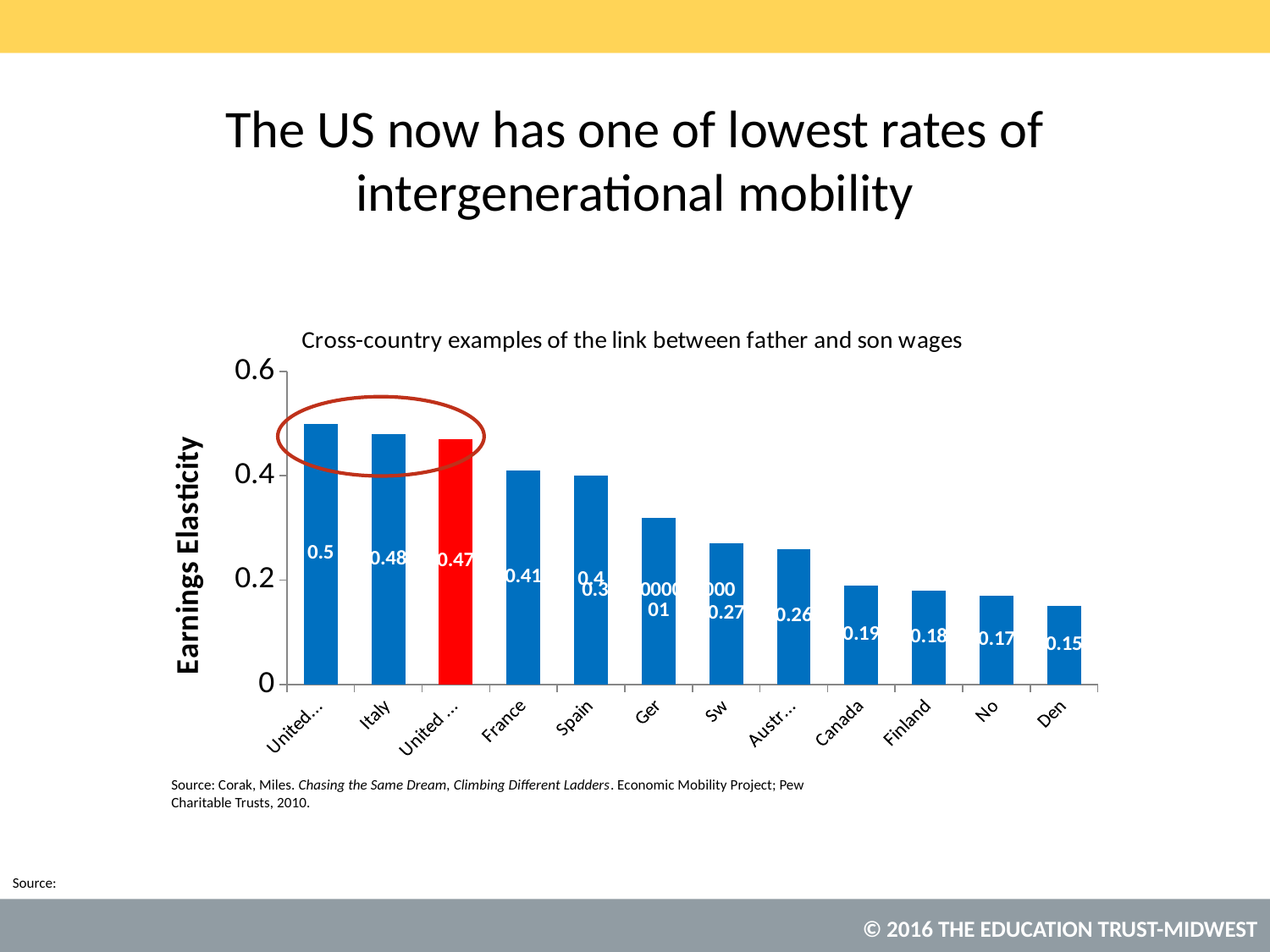
Which has a higher value, Spain or Sw? Spain What is the value shown for Canada? 0.19 What is the value shown for Spain? 0.4 How many countries are shown in the chart? 12 What is the value shown for France? 0.41 Is the value for Ger greater or less than 0.4? less What is the value of the tallest bar in the chart? 0.5 What is the earnings elasticity value for Italy? 0.48 What is the value of the red bar? 0.47 Which country has the lowest earnings elasticity? Den What is the difference between the values for Italy and France? 0.07 What is the value shown for Finland? 0.18